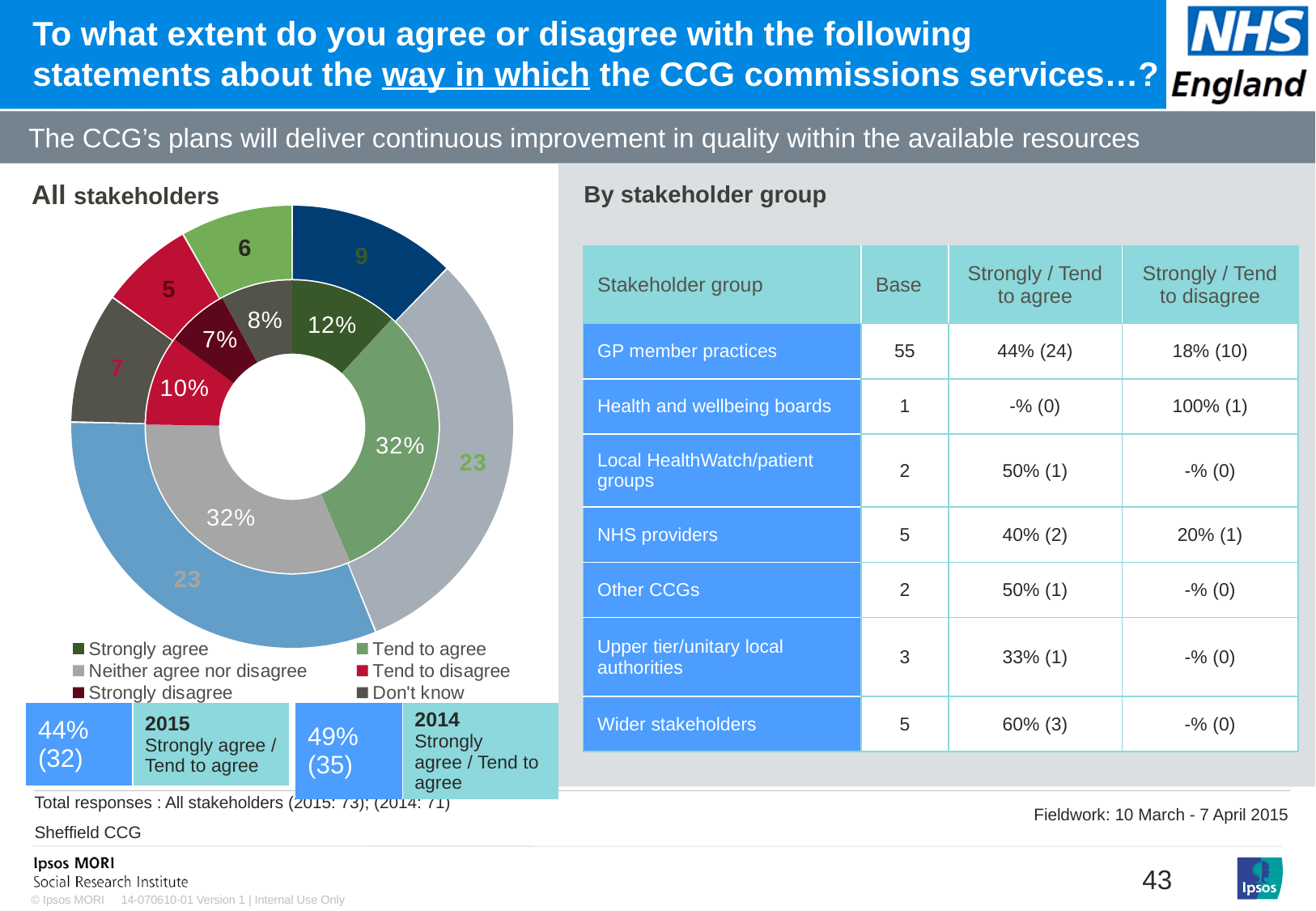
In the 'All stakeholders' chart, what percentage of respondents tend to disagree? 10% In the 'All stakeholders' chart, which is larger: the share for 'Tend to disagree' or for 'Don't know'? Tend to disagree How many response categories does the legend of the 'All stakeholders' chart list? 6 According to the summary box below the chart, what was the combined 'Strongly agree / Tend to agree' figure for 2015? 44% (32) In the 'All stakeholders' chart, what percentage of respondents strongly disagree? 7% In the 'All stakeholders' chart, what percentage of respondents strongly agree? 12% In the 'All stakeholders' chart, what is the difference in percentage points between 'Strongly agree' and 'Strongly disagree'? 5 percentage points What kind of chart is shown under 'All stakeholders'? Doughnut chart In the 'All stakeholders' chart, which response category has the smallest percentage? Strongly disagree In the 'All stakeholders' chart, what percentage of respondents answered 'Don't know'? 8% According to the summary box below the chart, what was the combined 'Strongly agree / Tend to agree' figure for 2014? 49% (35) In the 'All stakeholders' chart, what percentage of respondents tend to agree? 32%